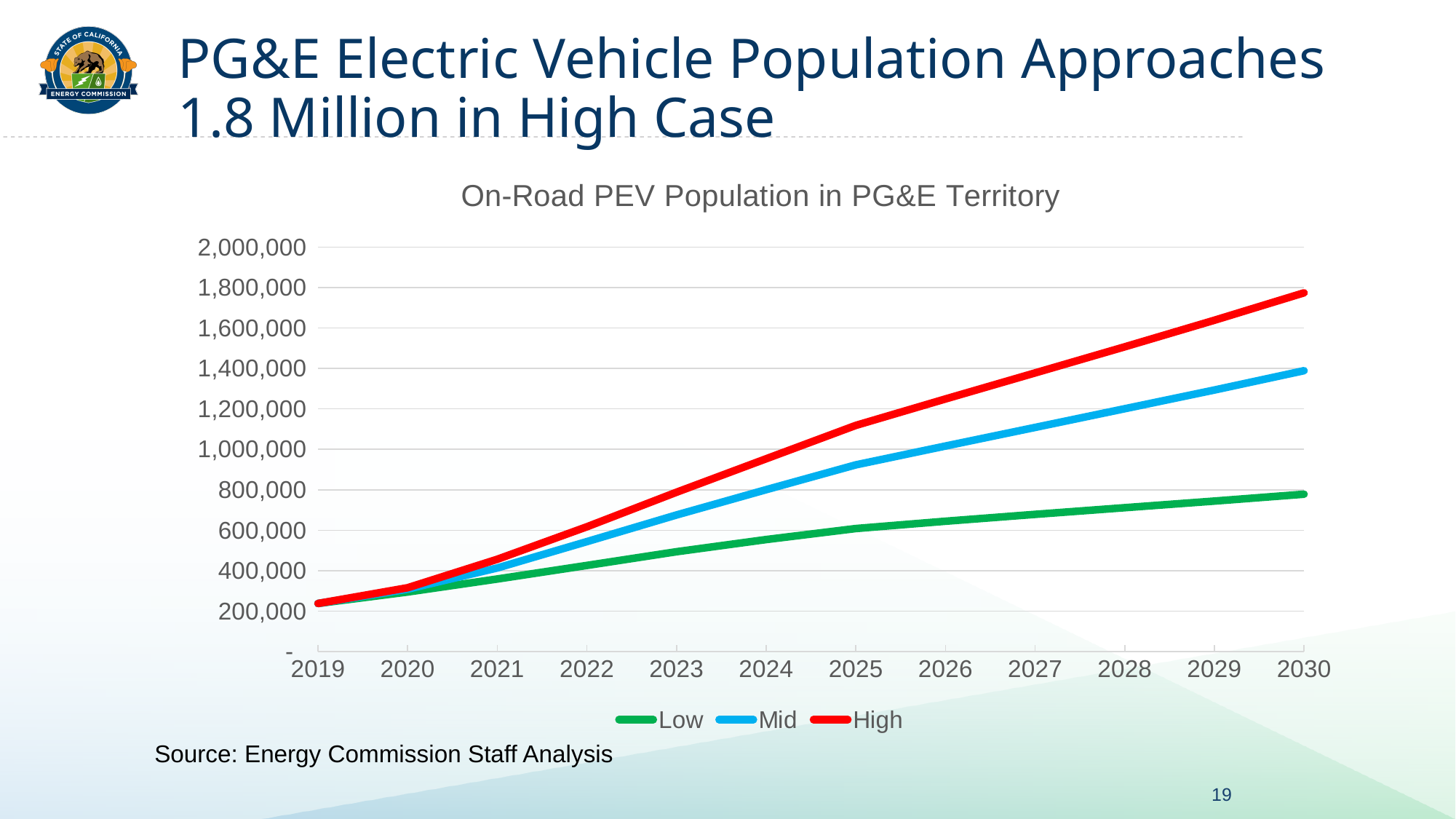
How many years are plotted along the x axis? 12 What kind of chart is shown on the slide? line chart Which series has the lowest value in 2030? Low What is the title of the chart? On-Road PEV Population in PG&E Territory Do the values for the High series rise or fall from 2019 to 2030? rise Is the value for the Low series in 2030 greater or less than 600,000? greater Is the value for the High series in 2030 greater or less than 1,600,000? greater How many series does the legend list? 3 In 2027, which is larger, the Mid series or the Low series? Mid Is the value for the Mid series in 2025 greater or less than 1,000,000? less Which series has the highest value in 2030? High Which series is drawn in red? High